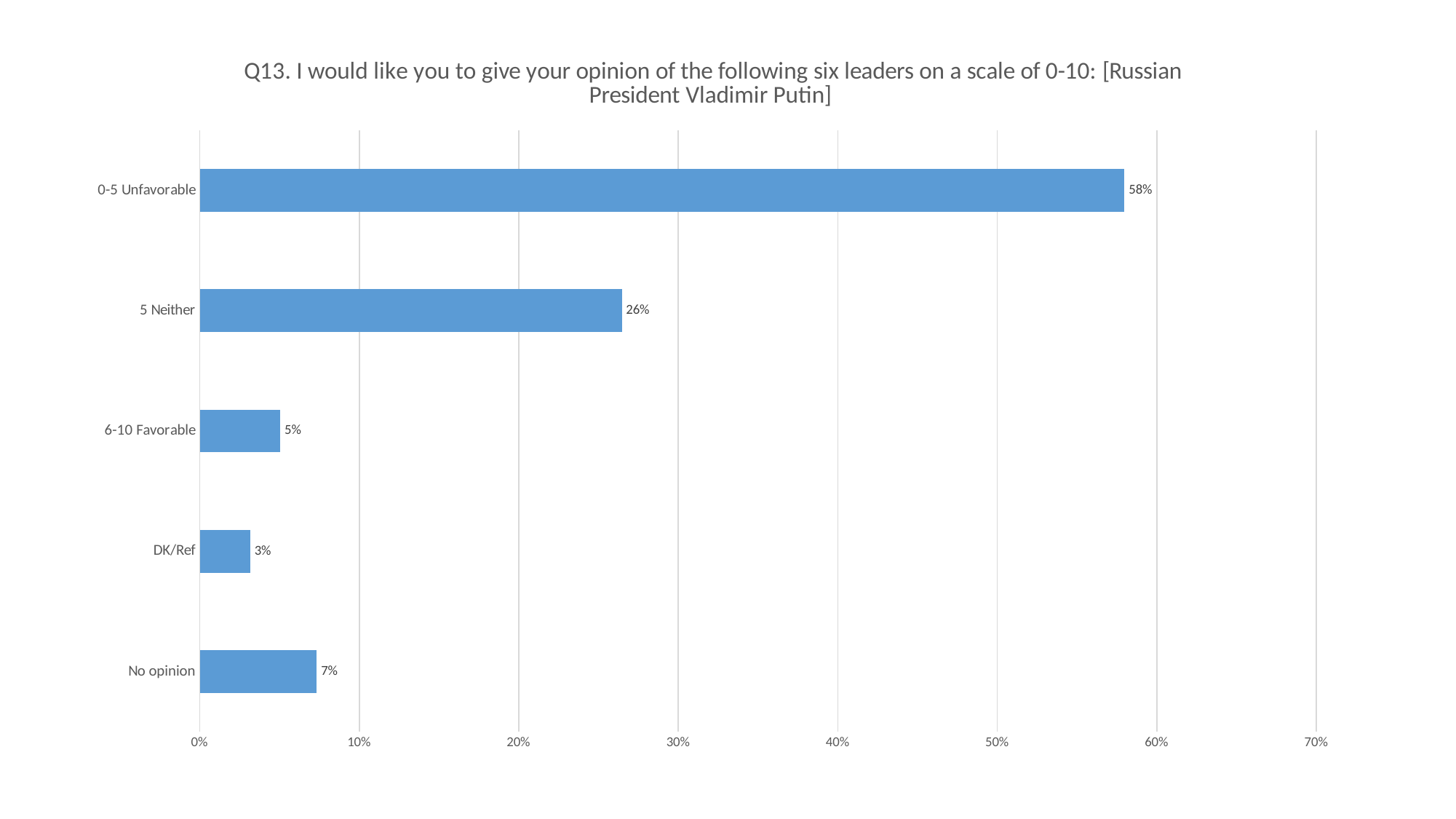
How many categories are shown in the chart? 5 Which category has the highest value? 0-5 Unfavorable What kind of chart is shown on the slide? Bar chart What is the difference between the 0-5 Unfavorable and 5 Neither values? 32 percentage points What percentage of respondents gave a 0-5 Unfavorable rating? 58% What percentage gave a 6-10 Favorable rating? 5% Is the value for 5 Neither greater or less than 30%? less Which is larger, the value for No opinion or the value for 6-10 Favorable? No opinion Which category has the lowest value? DK/Ref What is the value for No opinion? 7% What is the value for DK/Ref? 3% What is the value for the 5 Neither category? 26%